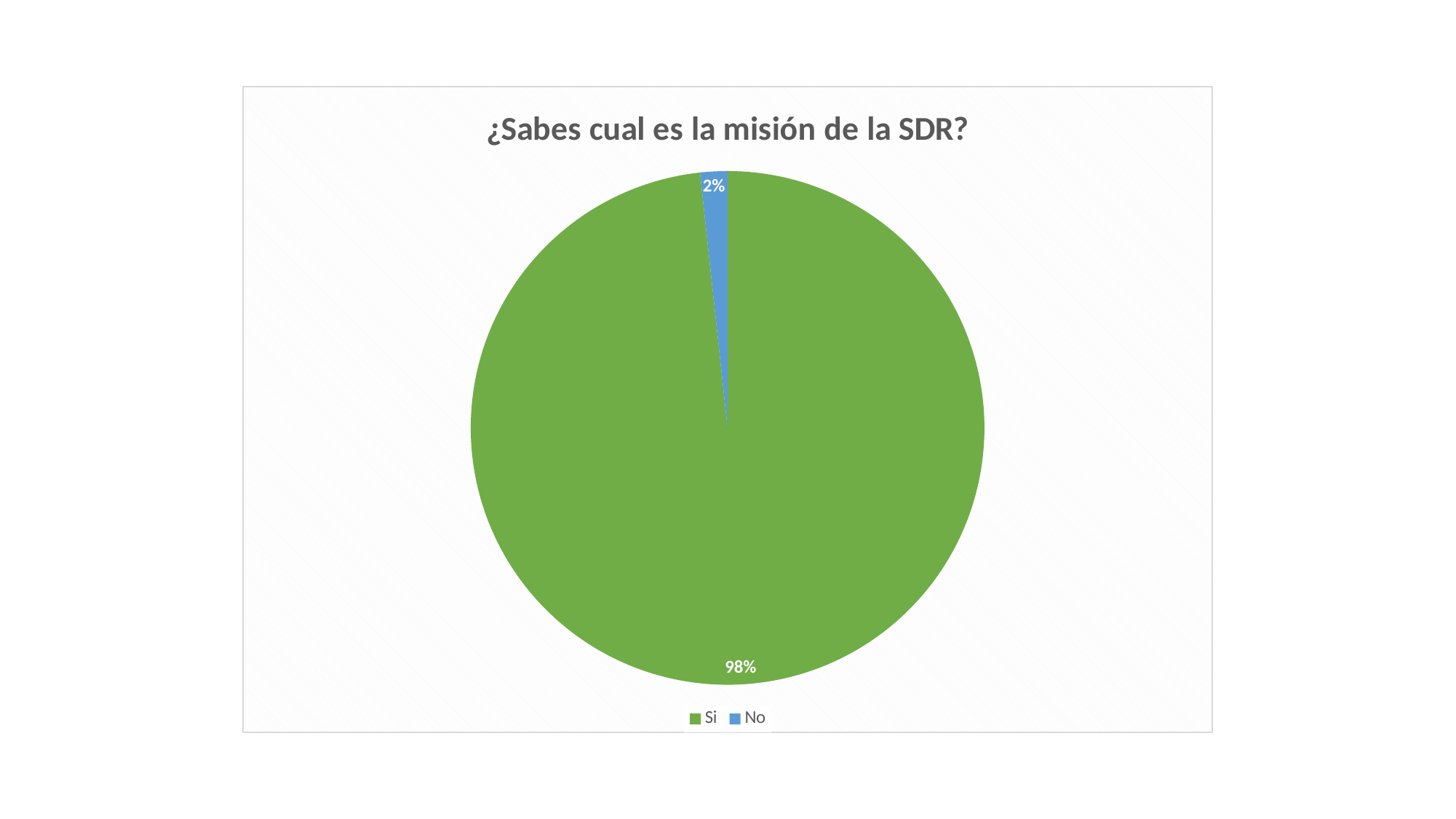
How many categories does the pie chart show? 2 What is the difference in percentage points between the 'Si' and 'No' slices? 96 Which category has the smallest slice of the pie? No What share of the pie does the 'No' slice represent? 2% What kind of chart is shown on the slide? pie chart How many entries does the legend list? 2 What is the title of the chart? ¿Sabes cual es la misión de la SDR? What share of the pie does the 'Si' slice represent? 98% Which slice is larger, 'Si' or 'No'? Si What colour is the 'No' slice? blue Which category has the largest slice of the pie? Si